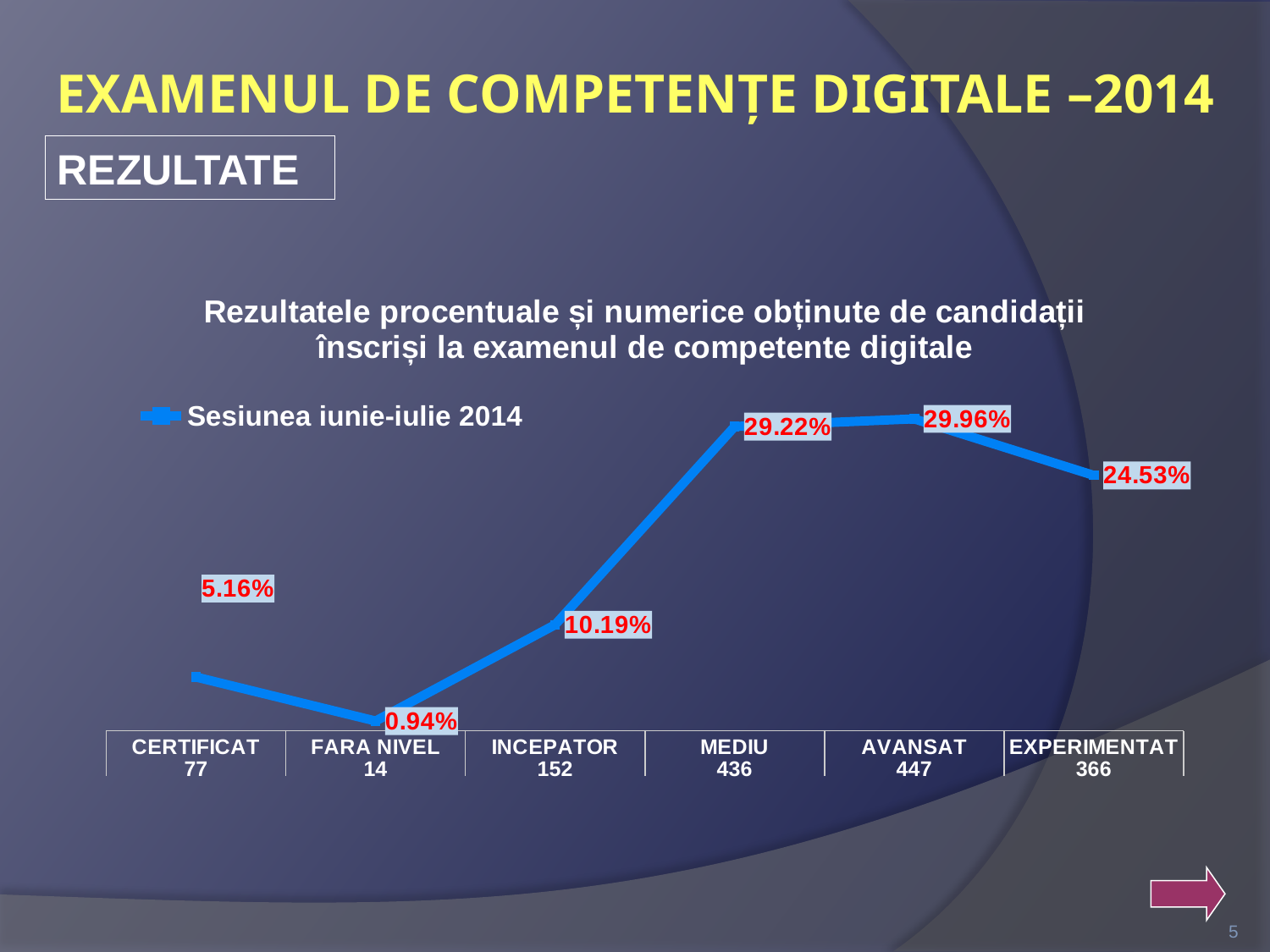
What percentage is shown for the EXPERIMENTAT category? 24.53% What is the difference between the percentages for INCEPATOR and CERTIFICAT? 5.03% What percentage is shown for the FARA NIVEL category? 0.94% Which category has the highest percentage? AVANSAT Which has a larger percentage, CERTIFICAT or INCEPATOR? INCEPATOR What kind of chart is shown on the slide? Line chart What percentage is shown for the MEDIU category? 29.22% Do the values rise or fall from INCEPATOR to MEDIU? Rise Which category has the lowest percentage? FARA NIVEL What is the difference between the percentages for AVANSAT and MEDIU? 0.74% How many series does the legend list? 1 How many categories are shown on the x axis? 6